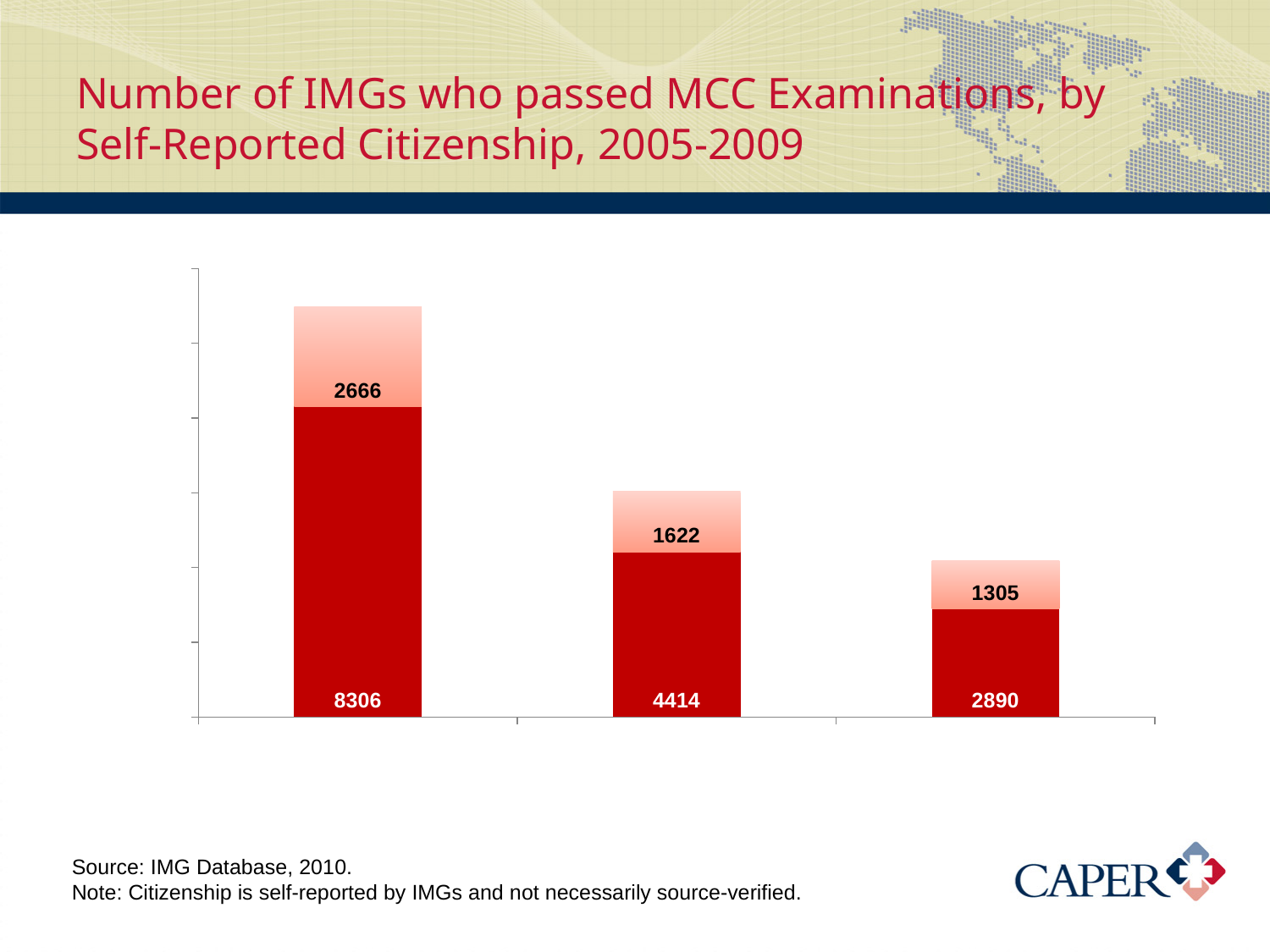
Which bar has the highest dark red segment value: the left, middle, or right bar? left What is the value of the light pink segment of the rightmost bar? 1305 What is the difference between the dark red segment values of the left bar and the middle bar? 3892 What kind of chart is shown on the slide? stacked bar chart Is the light pink segment of the middle bar larger or smaller than the light pink segment of the right bar? larger What is the value of the dark red segment of the leftmost bar? 8306 How many bars are shown in the chart? 3 What is the total of the leftmost stacked bar? 10972 What is the value of the light pink segment of the leftmost bar? 2666 Which bar has the lowest light pink segment value: the left, middle, or right bar? right What is the total of the rightmost stacked bar? 4195 What is the value of the dark red segment of the middle bar? 4414